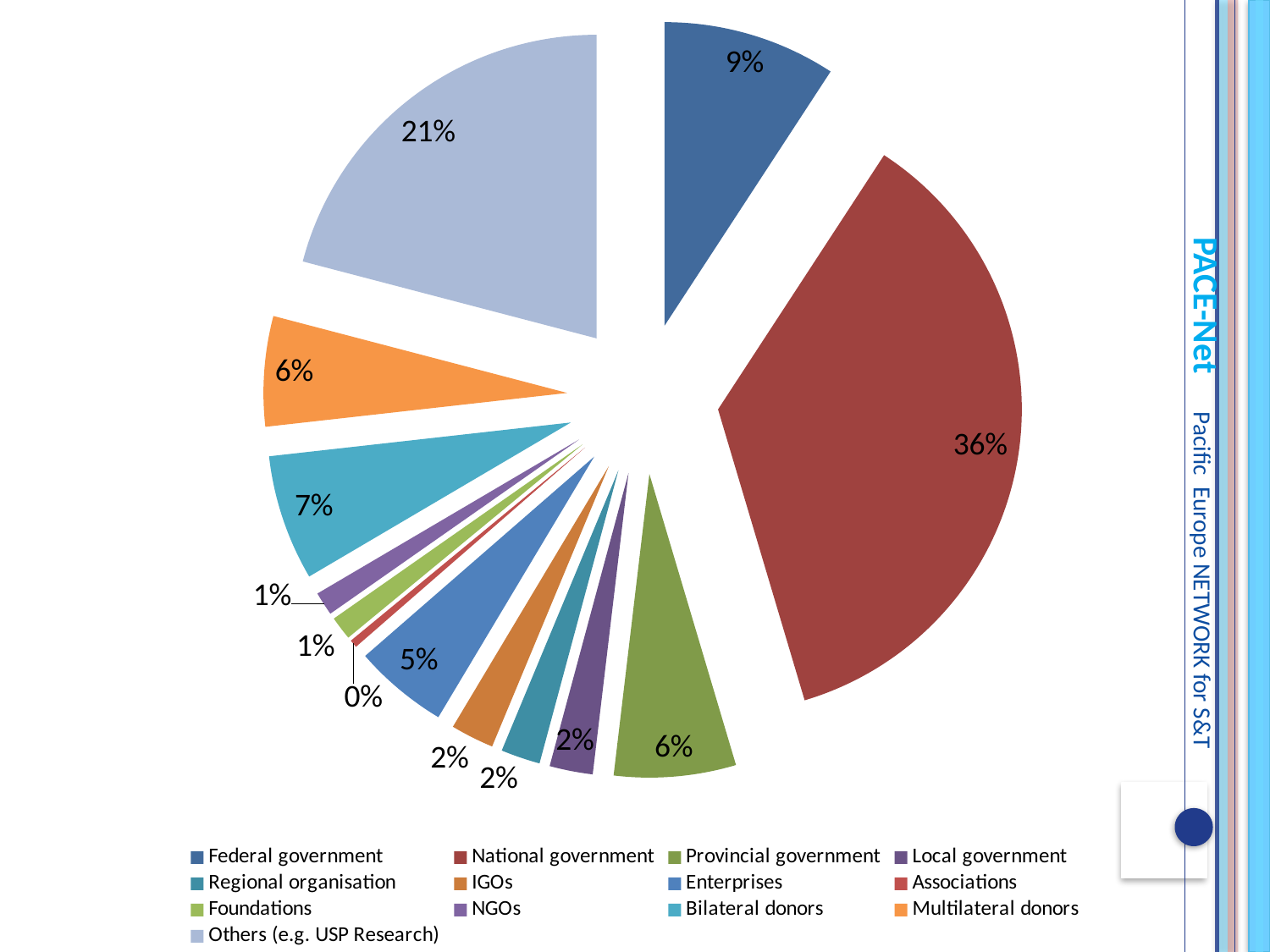
What percentage is shown for Others (e.g. USP Research)? 21% What share of the pie does National government account for? 36% Which category has the largest slice of the pie? National government How many categories does the legend list? 13 What percentage is shown for Enterprises? 5% What percentage is shown for Federal government? 9% What type of chart is shown on the slide? pie chart What is the difference in percentage points between National government and Others (e.g. USP Research)? 15 Which category has the smallest slice of the pie? Associations Which is larger, the share for Bilateral donors or the share for Multilateral donors? Bilateral donors What colour is the slice for National government? red What percentage is shown for Bilateral donors? 7%